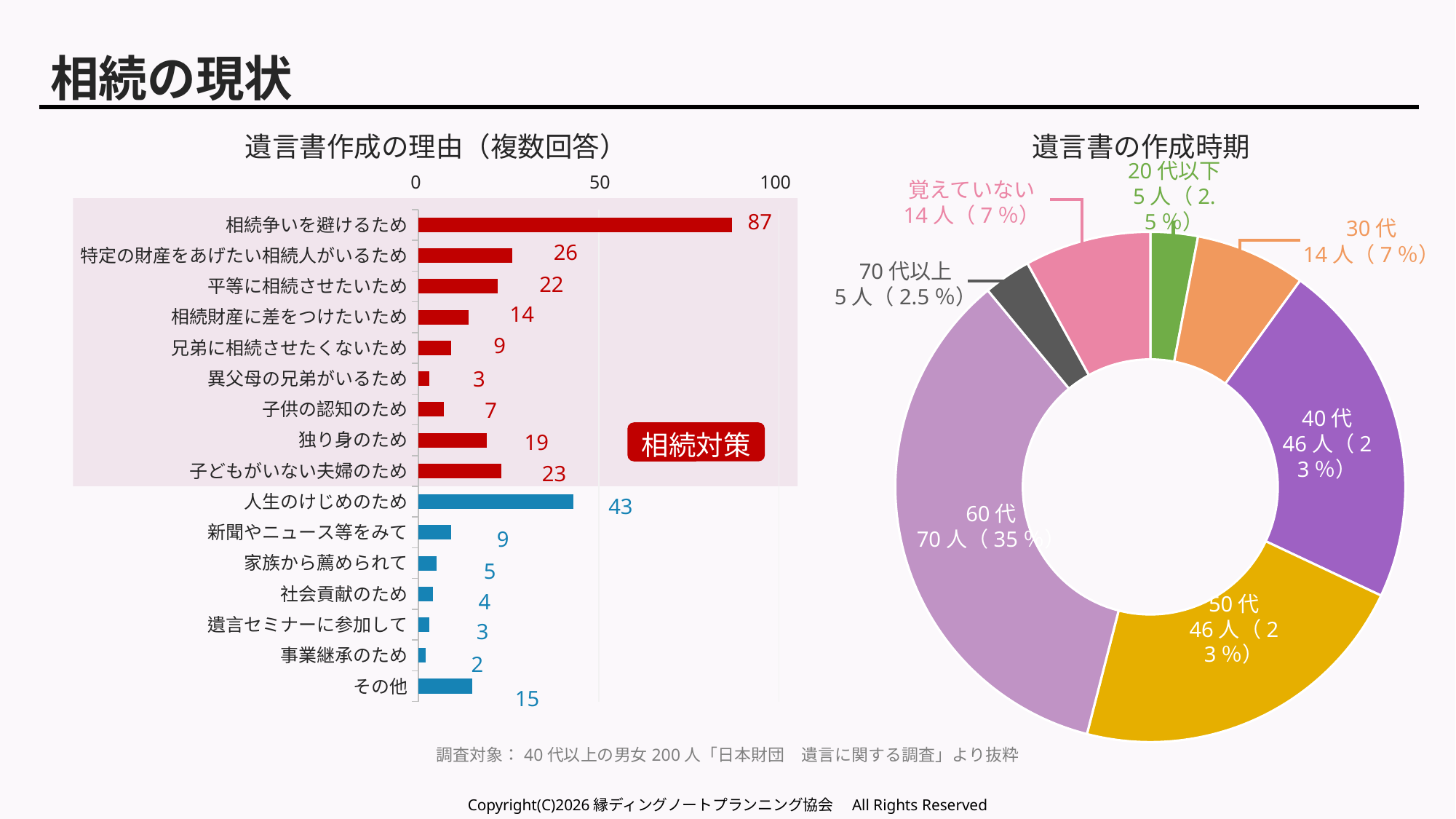
In the chart titled 遺言書作成の理由（複数回答）, which category has the lowest value? 事業継承のため In the chart titled 遺言書作成の理由（複数回答）, what is the difference between 特定の財産をあげたい相続人がいるため and 平等に相続させたいため? 4 In the chart titled 遺言書の作成時期, which age group has the largest share? 60代 What kind of chart is the one titled 遺言書作成の理由（複数回答）? Bar chart In the chart titled 遺言書作成の理由（複数回答）, how many categories are plotted? 16 In the chart titled 遺言書の作成時期, what share does 30代 represent? 7% In the chart titled 遺言書作成の理由（複数回答）, what is the label in the red box over the shaded area? 相続対策 In the chart titled 遺言書作成の理由（複数回答）, what is the value for 人生のけじめのため? 43 In the chart titled 遺言書作成の理由（複数回答）, what is the value for 相続争いを避けるため? 87 In the chart titled 遺言書の作成時期, how many people are in the 60代 segment? 70人（35%） In the chart titled 遺言書作成の理由（複数回答）, which is larger: 独り身のため or 子どもがいない夫婦のため? 子どもがいない夫婦のため In the chart titled 遺言書の作成時期, how many segments are there? 7